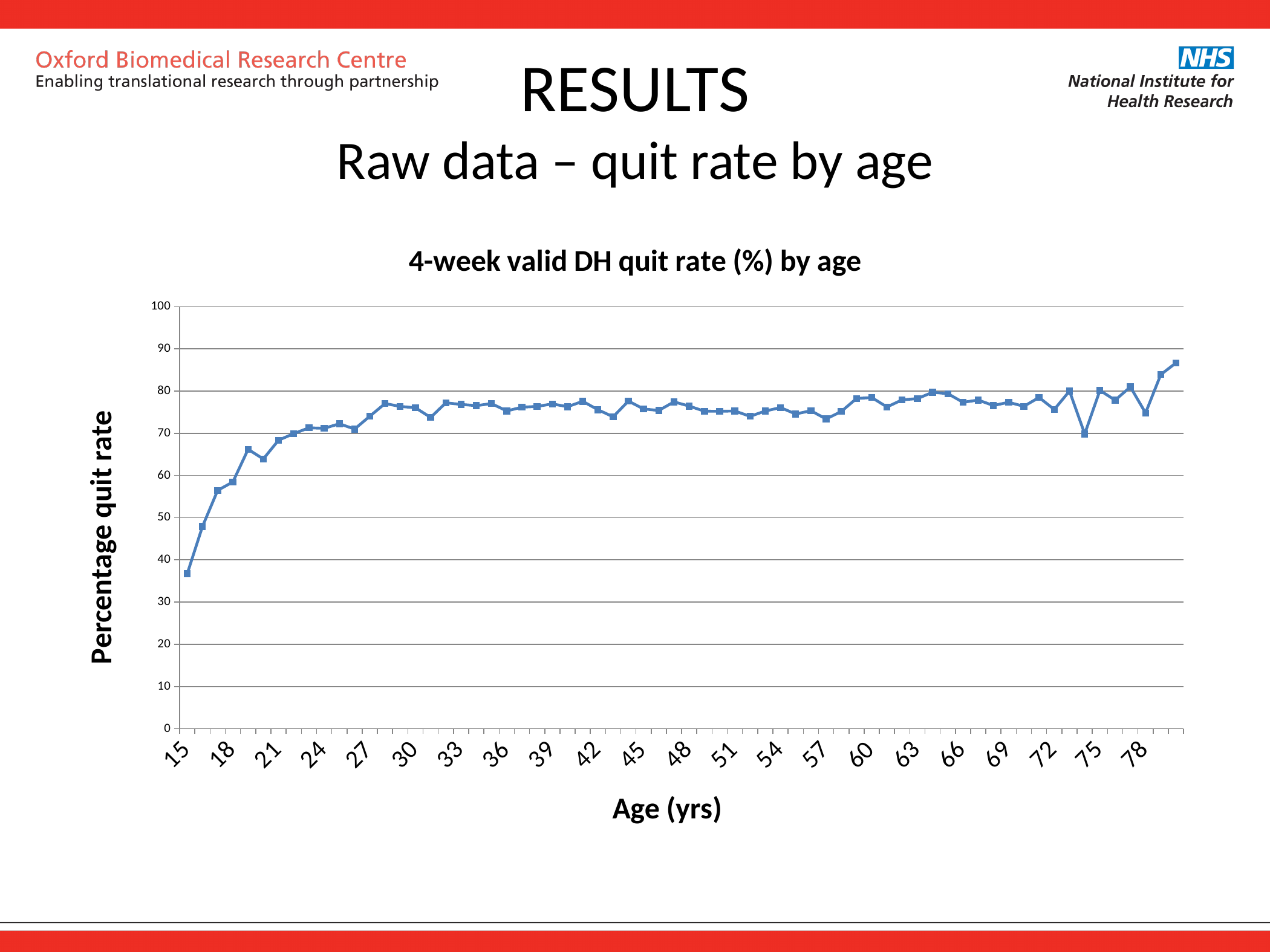
Is the quit rate for age 27 greater or less than 70? greater What is the title of the chart? 4-week valid DH quit rate (%) by age Which age has the lowest quit rate on the chart? 15 Is the quit rate for age 45 greater or less than 60? greater Is the quit rate for age 21 greater or less than 60? greater Which has the higher quit rate, age 15 or age 27? age 27 Does the quit rate rise or fall between age 15 and age 27? rise Which has the higher quit rate, age 18 or age 21? age 21 What kind of chart is shown on the slide? line chart What is the label on the vertical axis of the chart? Percentage quit rate